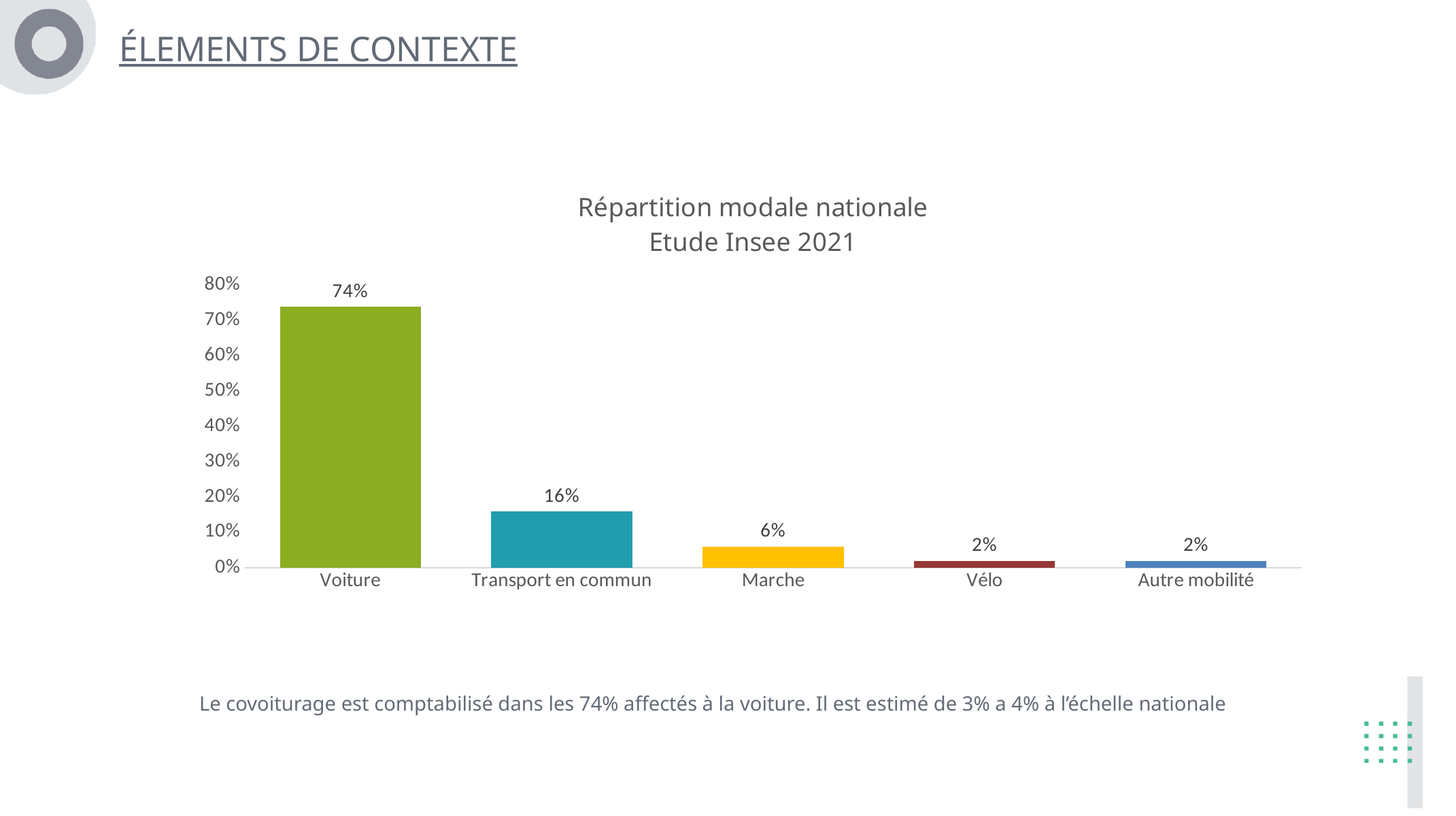
How many categories are shown on the x axis? 5 What is the value for Marche? 6% What is the title of the chart? Répartition modale nationale Etude Insee 2021 What kind of chart is shown on the slide? bar chart What is the difference between the values for Voiture and Transport en commun? 58% Which category has the highest value? Voiture What is the value for Voiture? 74% What is the value for Transport en commun? 16% Is the value for Voiture greater or less than 70%? greater What is the value for Vélo? 2% Which is larger, the value for Marche or the value for Vélo? Marche What is the difference between the values for Transport en commun and Marche? 10%